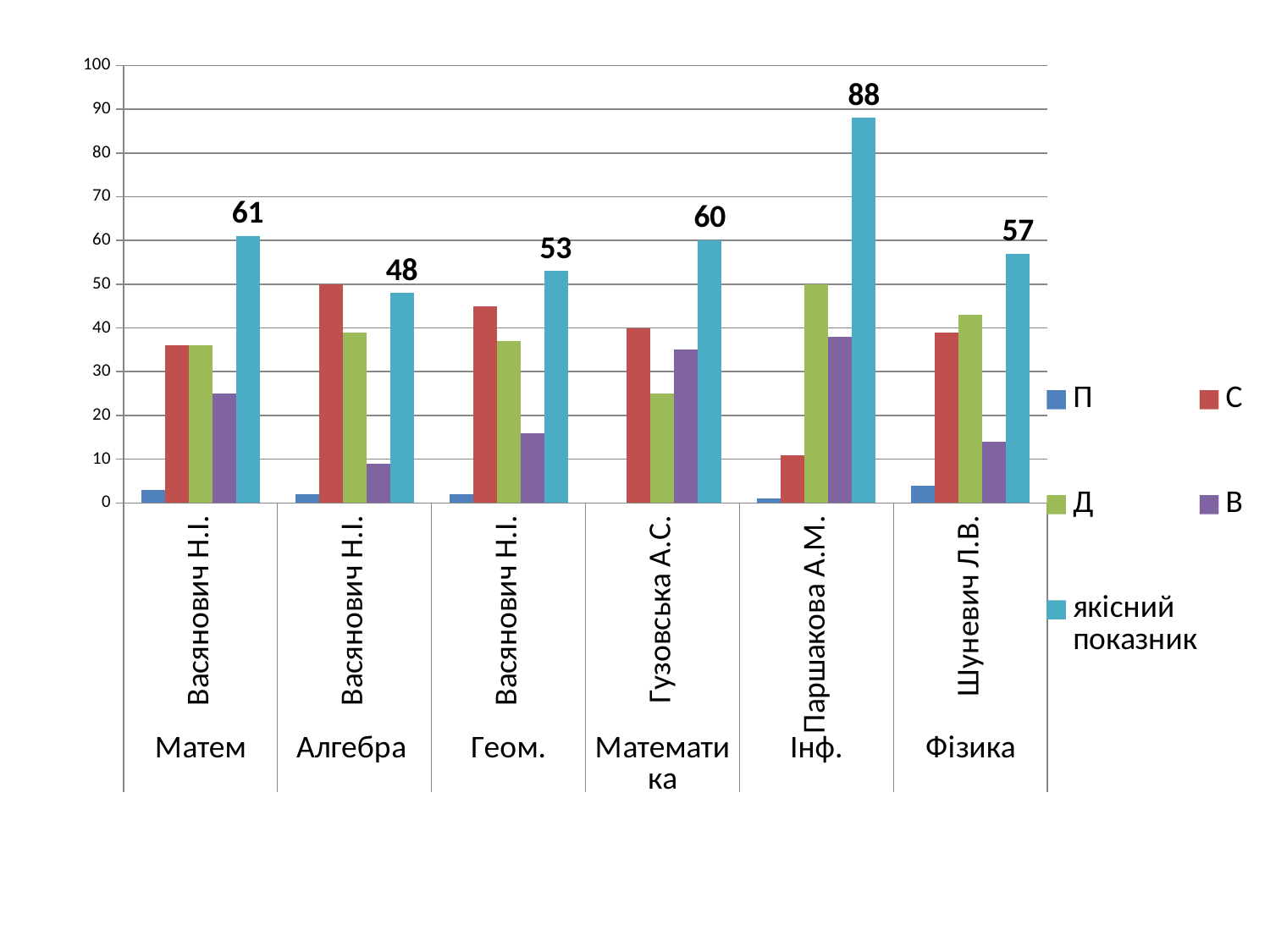
Which is larger, the якісний показник for Матем or for Математика? Матем How many subject categories are shown on the x axis? 6 Is the value of series В for Інф. greater or less than 30? greater What kind of chart is shown on the slide? bar chart Which series has its values printed as data labels above the bars? якісний показник Which subject has the lowest якісний показник? Алгебра What is the value of якісний показник for Матем (Васянович Н.І.)? 61 How many series does the legend list? 5 What is the value of якісний показник for Інф. (Паршакова А.М.)? 88 What is the difference between the якісний показник for Інф. and for Алгебра? 40 Which subject has the highest якісний показник? Інф. Is the value of series С for Геом. greater or less than 40? greater